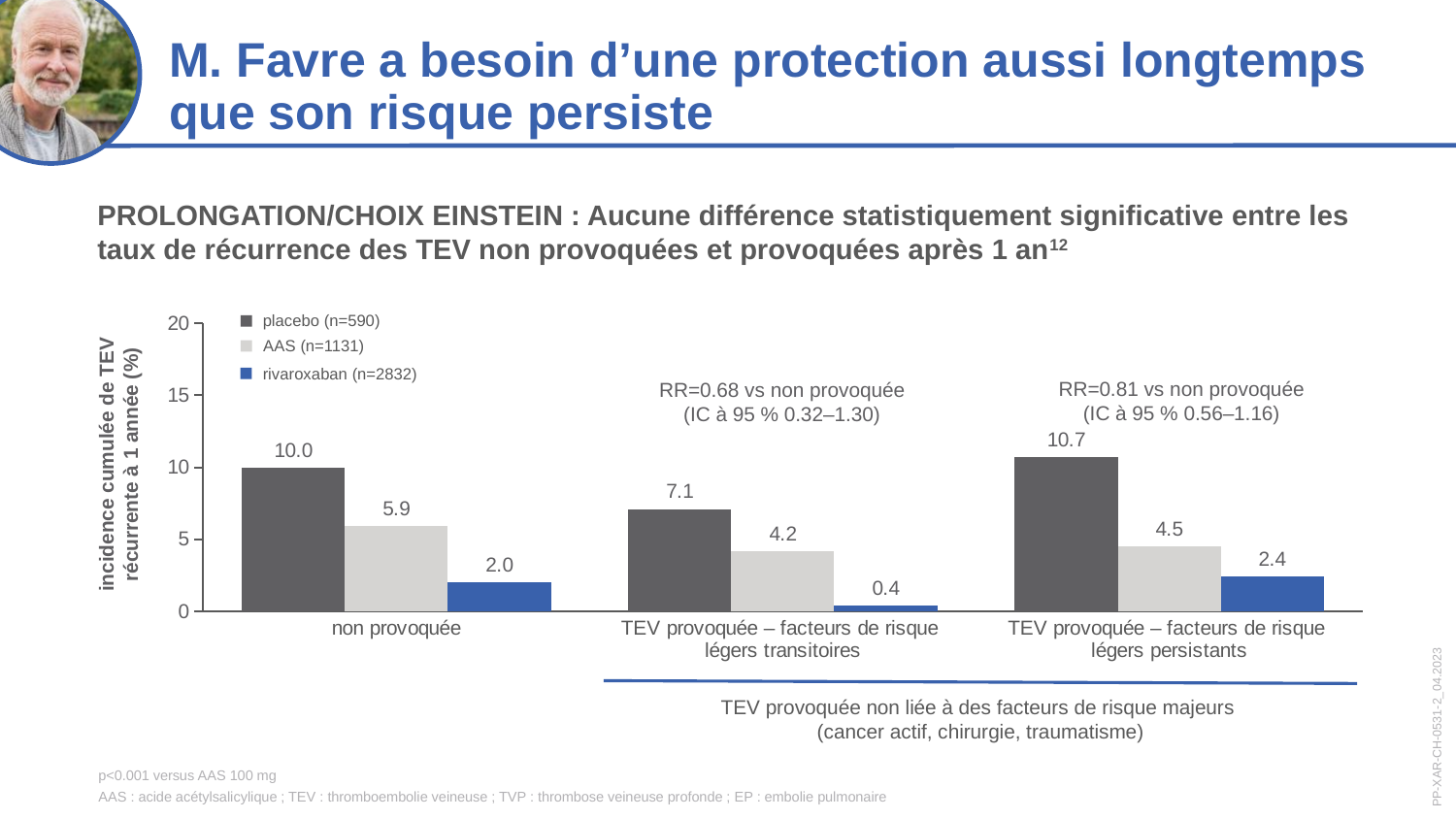
What is the value for AAS in the 'TEV provoquée – facteurs de risque légers persistants' category? 4.5 What is the value for rivaroxaban in the 'TEV provoquée – facteurs de risque légers transitoires' category? 0.4 Which category has the lowest rivaroxaban value? TEV provoquée – facteurs de risque légers transitoires What kind of chart is shown on the slide? bar chart How many series does the legend list? 3 What is the label of the y axis? incidence cumulée de TEV récurrente à 1 année (%) Which is larger: the AAS value for 'non provoquée' or the AAS value for 'TEV provoquée – facteurs de risque légers transitoires'? non provoquée What is the value for placebo in the 'non provoquée' category? 10.0 Is the placebo value for 'TEV provoquée – facteurs de risque légers persistants' greater or less than 10? greater Which category has the highest placebo value? TEV provoquée – facteurs de risque légers persistants How many categories are shown on the x axis? 3 What is the difference between the placebo and AAS values in the 'non provoquée' category? 4.1